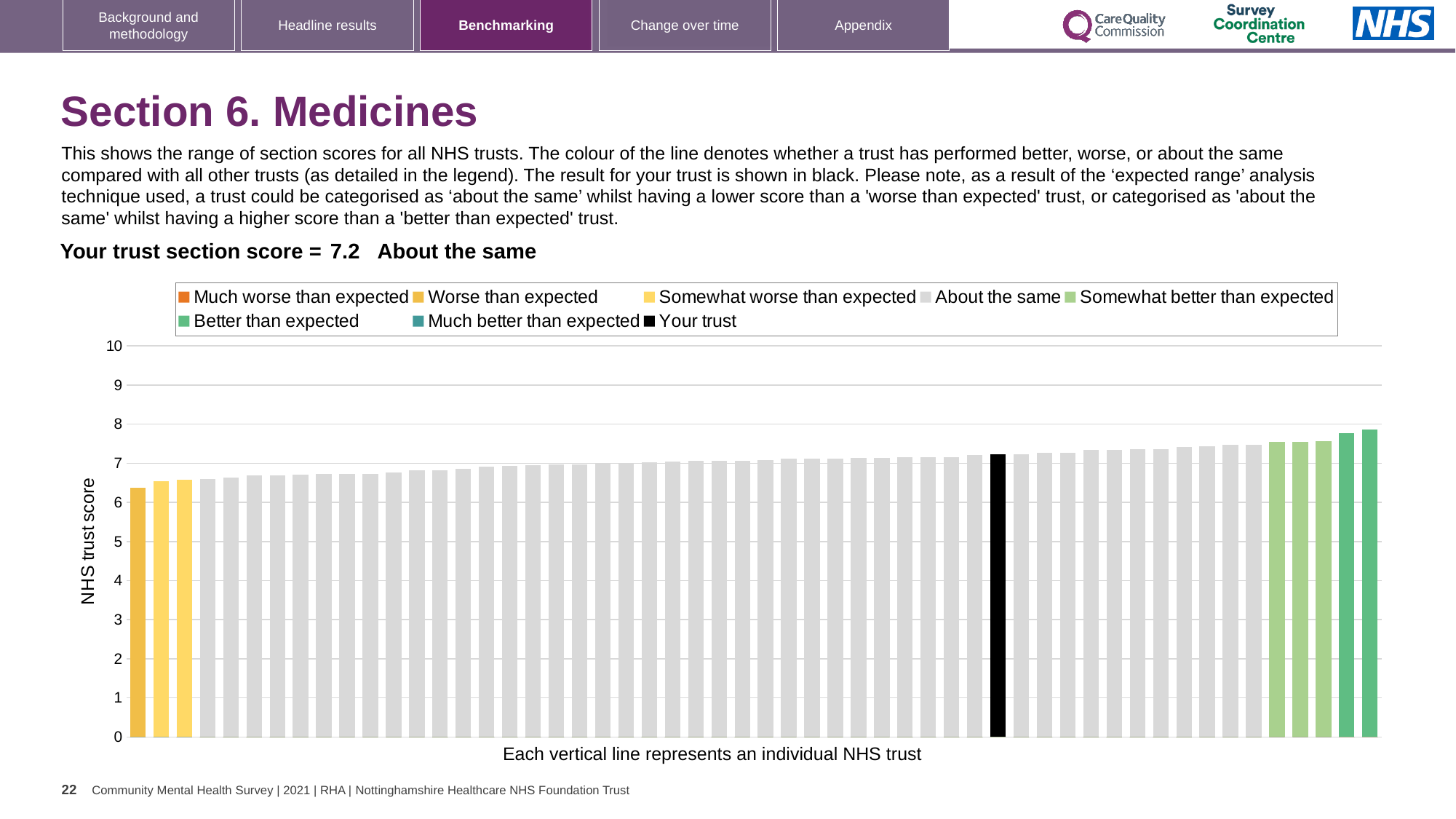
What is the label on the vertical axis of the chart? NHS trust score Do the bar values rise or fall from left to right along the x axis? rise What kind of chart is shown on the slide? bar chart How many entries does the chart legend list? 8 What is the section score for your trust shown on the chart? 7.2 Is the value for your trust (the black bar) greater or less than 7? greater What colour is used to show your trust on the chart? black Is the value of the lowest bar on the chart greater or less than 6? greater Which category does your trust fall into for Section 6. Medicines? About the same Is the value of the lowest bar on the chart greater or less than 7? less Which is larger: the value for your trust (black bar) or the value of the leftmost bar? your trust (black bar)